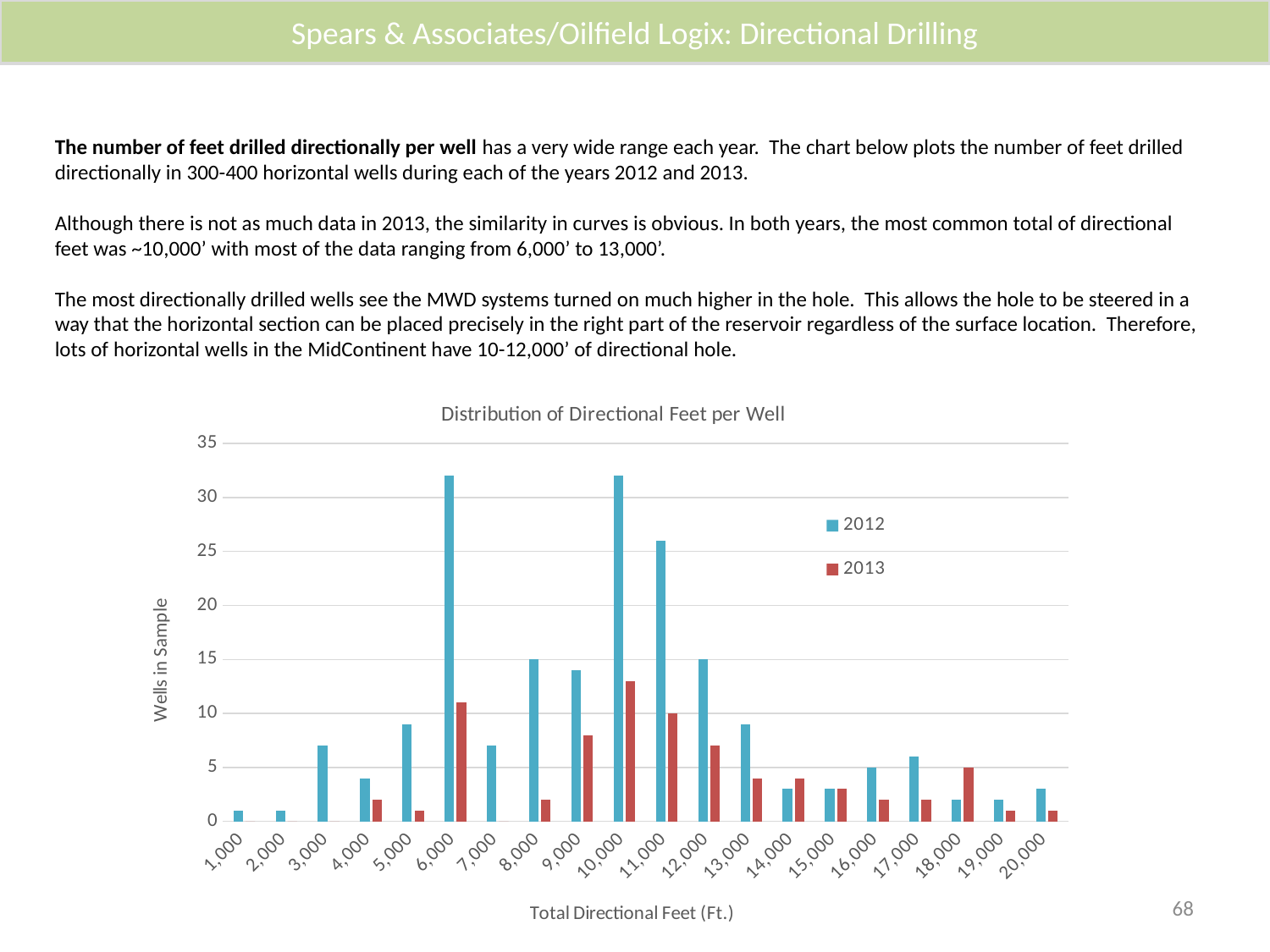
Is the 2012 value for 3,000 greater or less than 5? greater Is the 2012 value for 11,000 greater or less than 25? greater Which is larger at 10,000: the 2012 value or the 2013 value? 2012 Is the 2012 value for 6,000 greater or less than 30? greater Which category has the highest 2013 value? 10,000 What is the y-axis title of the chart? Wells in Sample What is the title of the chart? Distribution of Directional Feet per Well What type of chart is shown on the slide? bar chart Which is larger at 18,000: the 2012 value or the 2013 value? 2013 How many categories are shown along the x axis of the chart? 20 How many series does the chart legend list? 2